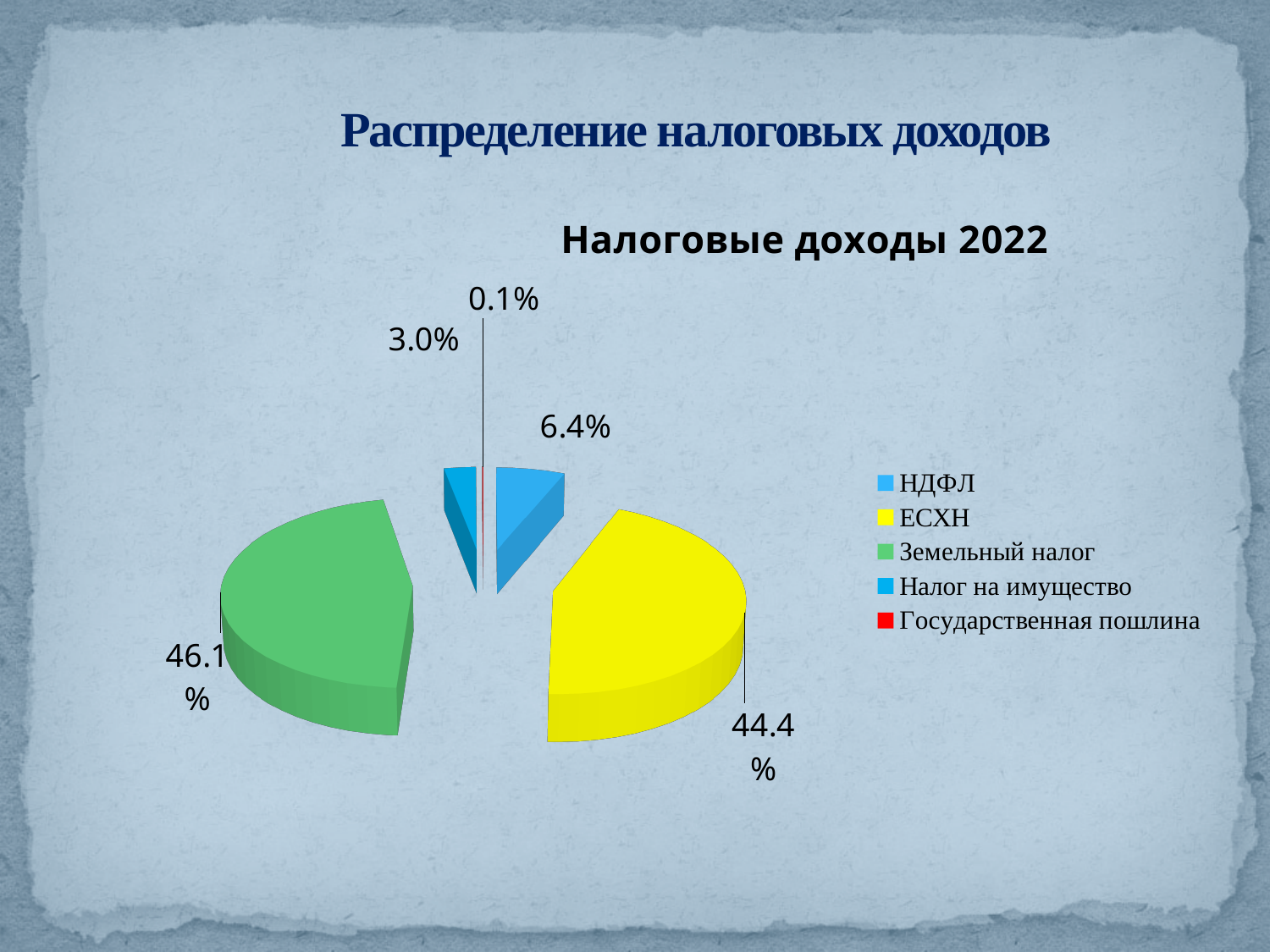
What share of the pie does Земельный налог have? 46.1% Which category has the largest share of the pie? Земельный налог What type of chart is shown on the slide? pie chart What is the title of the chart? Налоговые доходы 2022 What share of the pie does НДФЛ have? 6.4% How many categories does the legend of the chart list? 5 What is the difference in percentage points between the shares of Земельный налог and ЕСХН? 1.7 What share of the pie does Государственная пошлина have? 0.1% Which category has the smallest share of the pie? Государственная пошлина Which is larger, the share of НДФЛ or the share of Налог на имущество? НДФЛ